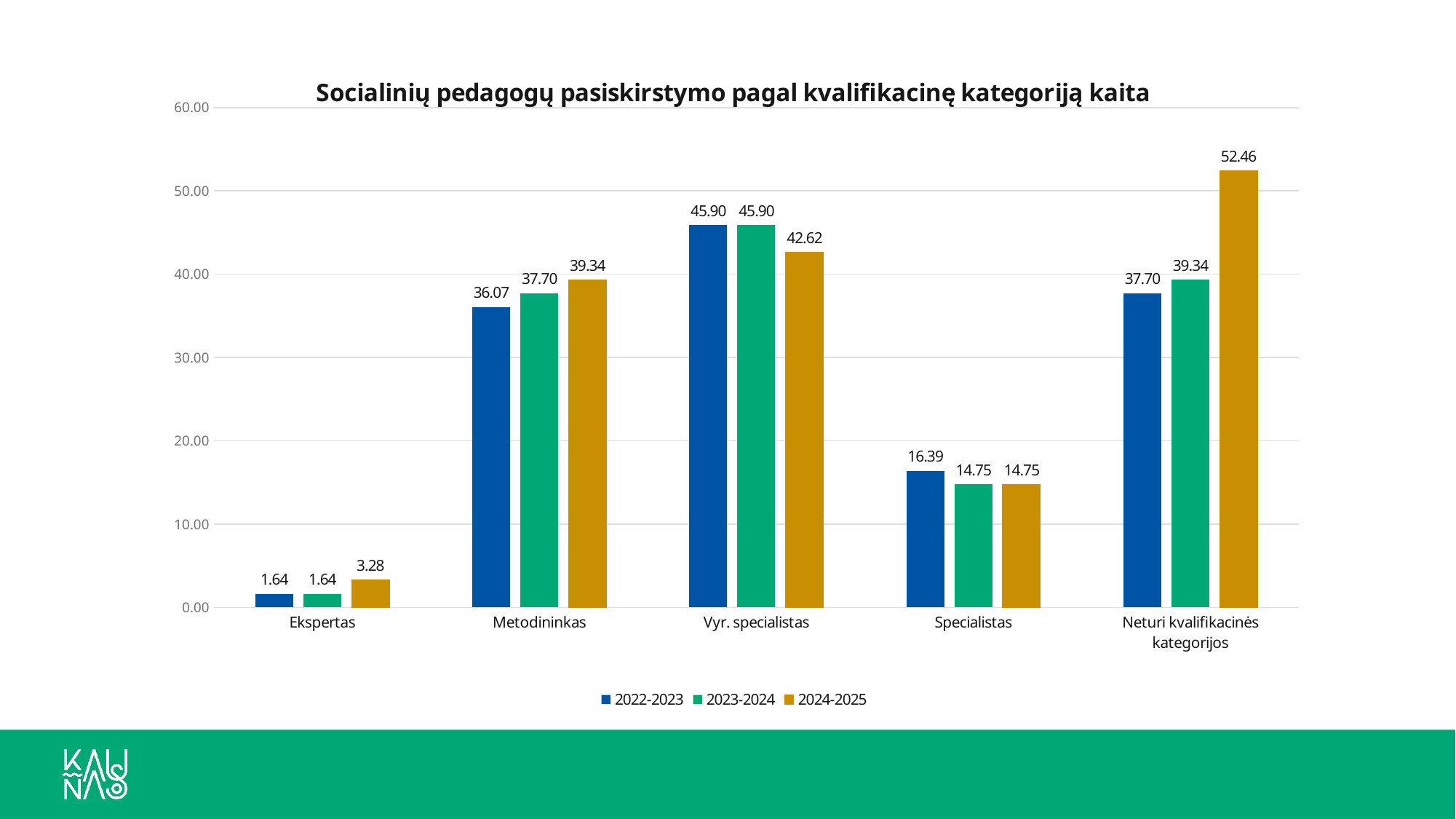
What is the value for Neturi kvalifikacinės kategorijos in the 2024-2025 series? 52.46 Is the 2024-2025 value for Metodininkas greater or less than 30.00? greater What is the difference between the 2024-2025 and 2022-2023 values for Neturi kvalifikacinės kategorijos? 14.76 How many categories are shown on the x axis? 5 How many series does the legend list? 3 What is the title of the chart? Socialinių pedagogų pasiskirstymo pagal kvalifikacinę kategoriją kaita Which is larger for Vyr. specialistas: the 2022-2023 value or the 2024-2025 value? 2022-2023 Which category has the lowest value in the 2022-2023 series? Ekspertas What kind of chart is shown on the slide? Bar chart What is the value for Specialistas in the 2023-2024 series? 14.75 What is the value for Metodininkas in the 2022-2023 series? 36.07 Which category has the highest value in the 2024-2025 series? Neturi kvalifikacinės kategorijos